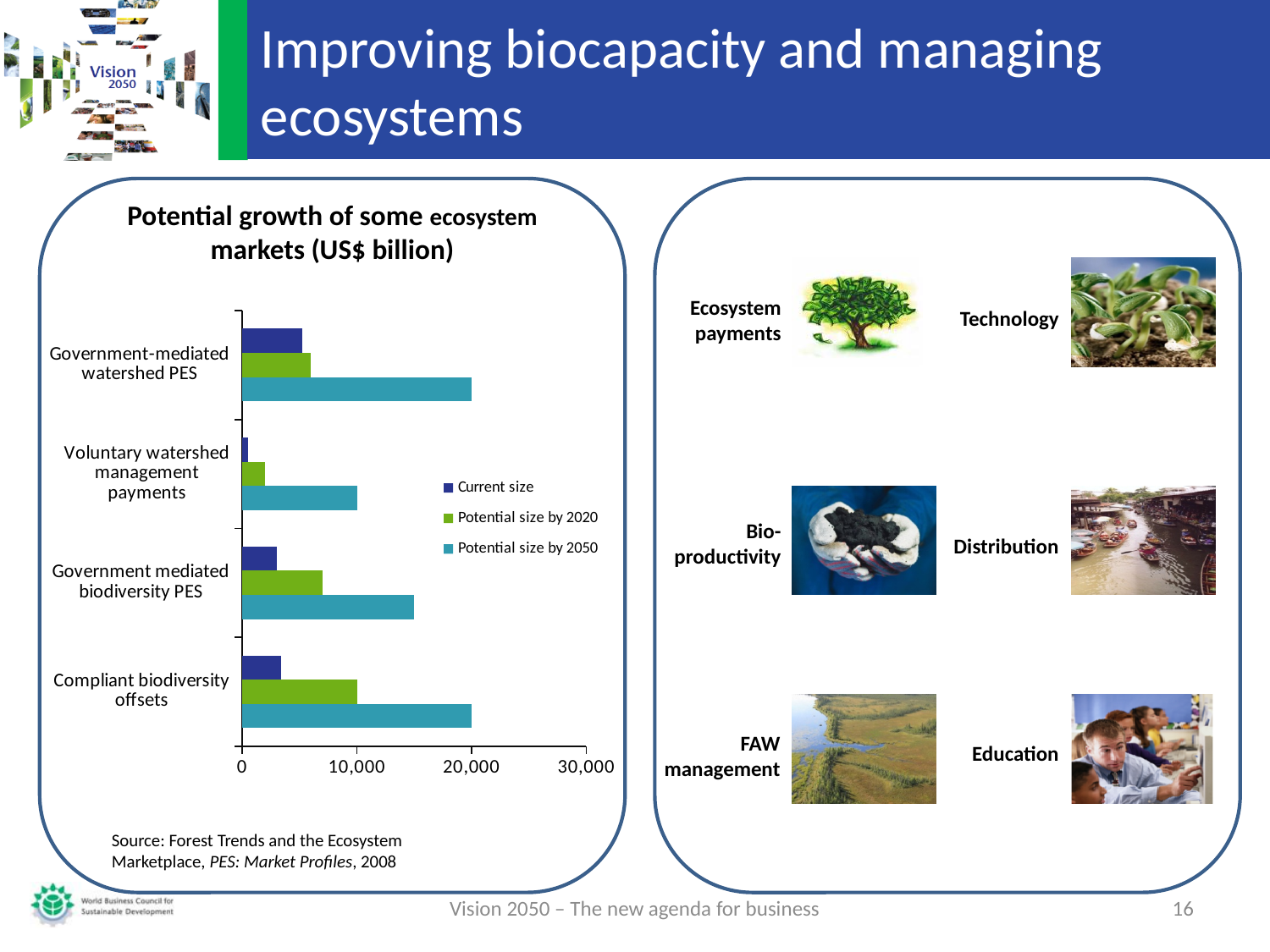
What is the Potential size by 2020 for Compliant biodiversity offsets? 10,000 Is the Potential size by 2050 for Government mediated biodiversity PES greater or less than 10,000? greater What kind of chart is shown on the slide? Bar chart What is the title of the chart? Potential growth of some ecosystem markets (US$ billion) How many series does the chart's legend list? 3 Which category has the lowest Current size? Voluntary watershed management payments What is the Potential size by 2050 for Compliant biodiversity offsets? 20,000 Is the Current size for Government-mediated watershed PES greater or less than 10,000? less What is the Potential size by 2050 for Voluntary watershed management payments? 10,000 What are the three series listed in the chart's legend? Current size, Potential size by 2020, Potential size by 2050 Which is larger: the Potential size by 2020 for Compliant biodiversity offsets or for Government mediated biodiversity PES? Compliant biodiversity offsets How many categories are shown on the chart? 4